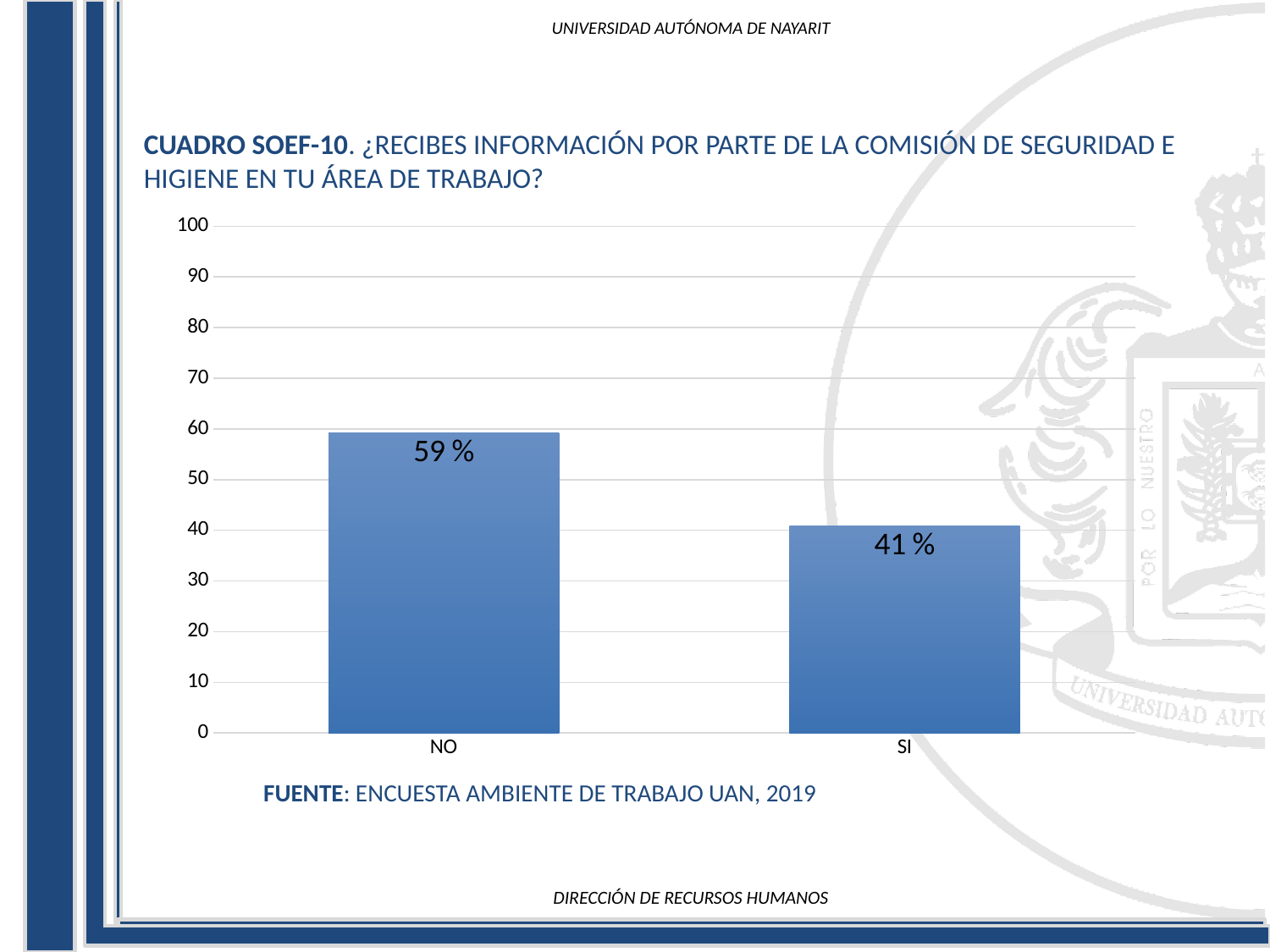
What is the value for NO? 59 % What kind of chart is shown on the slide? bar chart What is the difference between the values for NO and SI? 18 % What is the value for SI? 41 % How many categories are shown on the x axis? 2 Is the value for SI greater or less than 50? less Is the value for NO greater or less than 50? greater Which is larger, the value for NO or the value for SI? NO What is the maximum value shown on the y axis? 100 Which category has the lowest value? SI Which category has the highest value? NO What source is cited below the chart? ENCUESTA AMBIENTE DE TRABAJO UAN, 2019